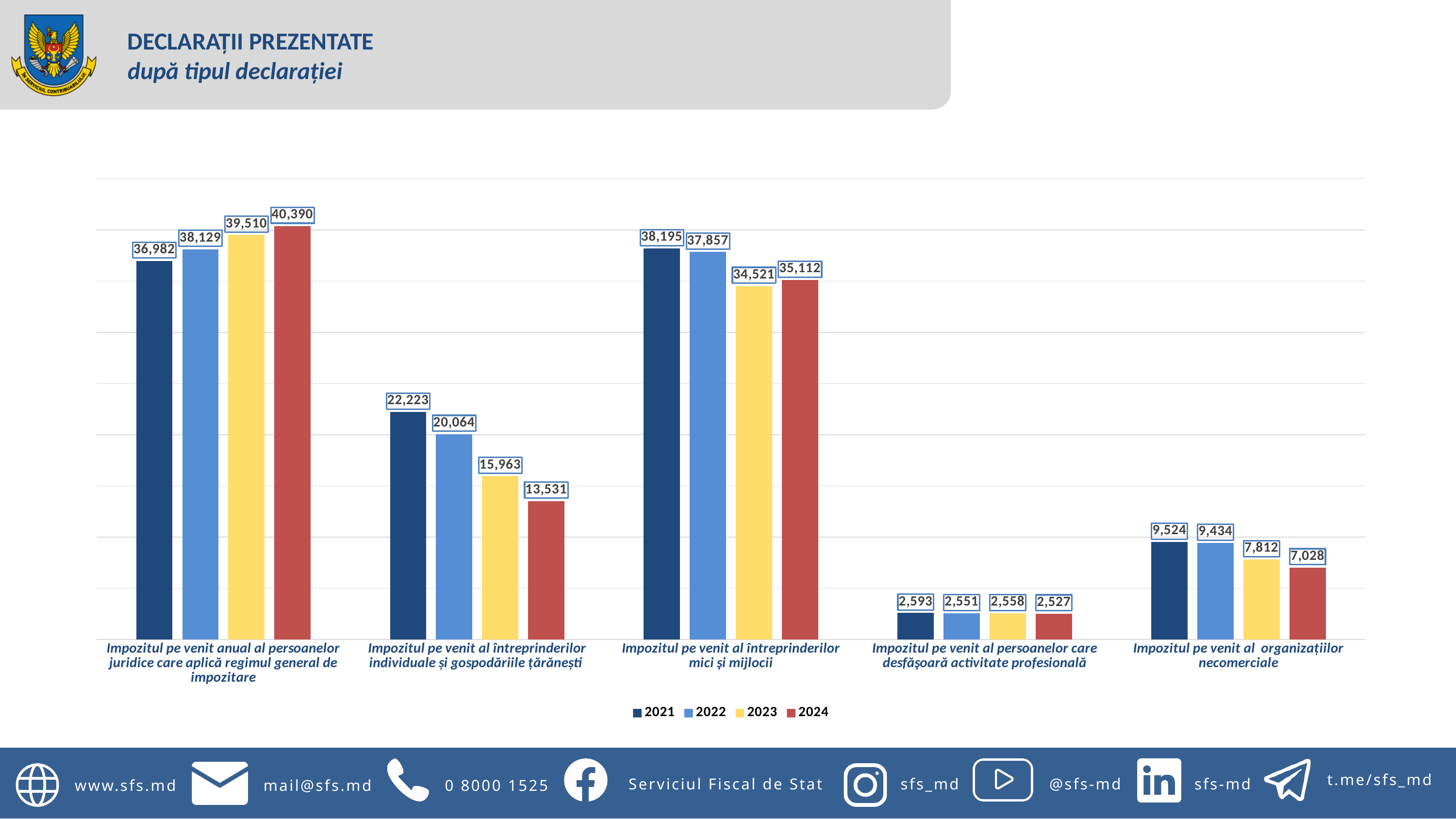
Which is larger for 'Impozitul pe venit al întreprinderilor mici și mijlocii': the 2023 value or the 2024 value? 2024 Which category has the lowest values across all years? Impozitul pe venit al persoanelor care desfășoară activitate profesională What is the 2022 value for 'Impozitul pe venit al organizațiilor necomerciale'? 9,434 What type of chart is shown on the slide? bar chart How many categories (declaration types) are shown on the x axis? 5 What is the 2021 value for 'Impozitul pe venit al întreprinderilor mici și mijlocii'? 38,195 Which year has the highest value for 'Impozitul pe venit anual al persoanelor juridice care aplică regimul general de impozitare'? 2024 What is the 2023 value for 'Impozitul pe venit al întreprinderilor individuale și gospodăriile țărănești'? 15,963 How many series does the legend list? 4 Do the values for 'Impozitul pe venit al organizațiilor necomerciale' rise or fall from 2021 to 2024? fall What is the 2024 value for 'Impozitul pe venit anual al persoanelor juridice care aplică regimul general de impozitare'? 40,390 What is the difference between the 2021 and 2024 values for 'Impozitul pe venit al întreprinderilor individuale și gospodăriile țărănești'? 8,692